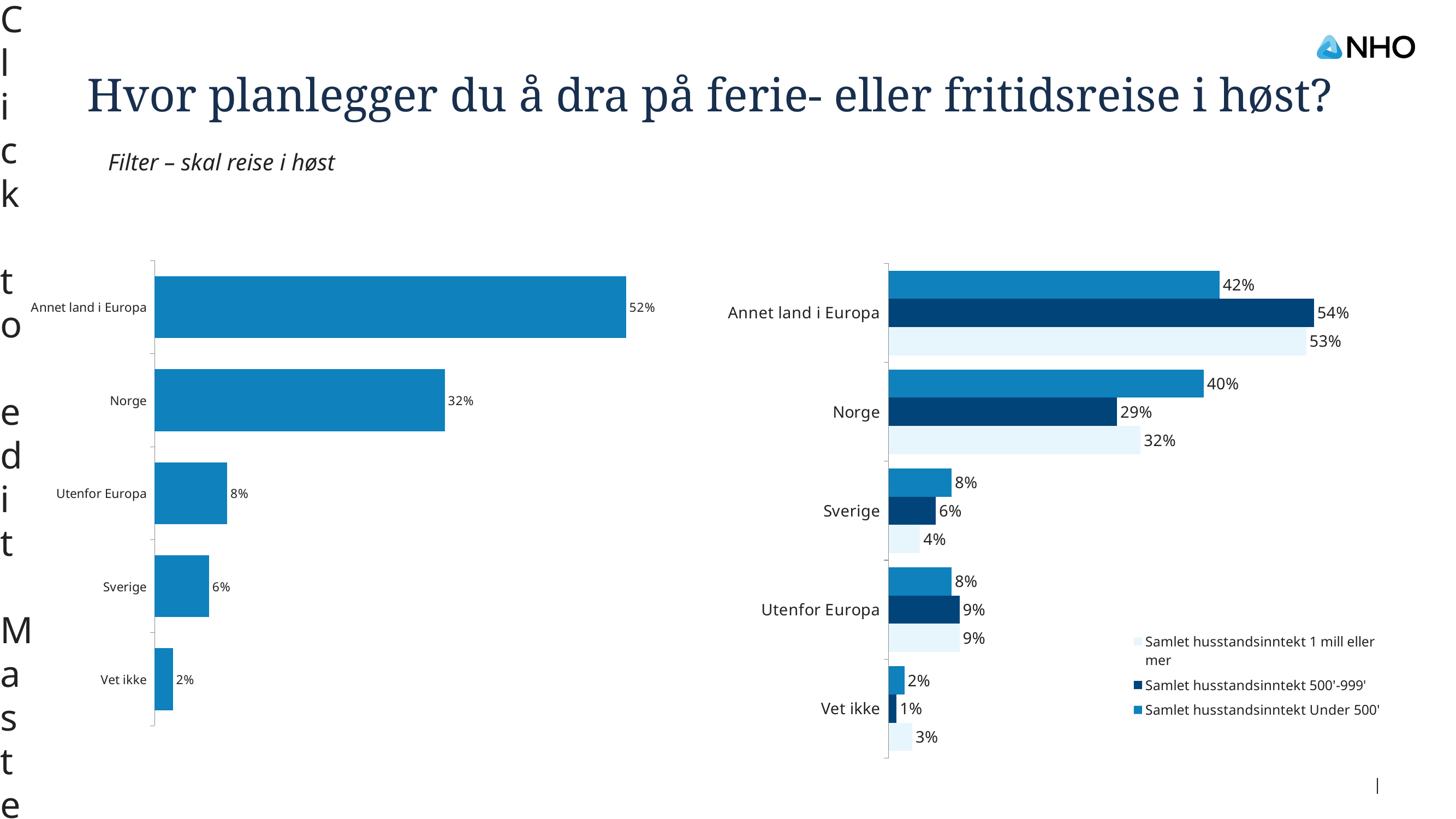
What kind of chart is the left chart? Bar chart In the right chart, what is the difference between Samlet husstandsinntekt Under 500' and Samlet husstandsinntekt 1 mill eller mer for Annet land i Europa? 11 percentage points In the right chart, what is the value for Annet land i Europa for Samlet husstandsinntekt 500'-999'? 54% In the right chart, for Norge, which is larger: Samlet husstandsinntekt Under 500' or Samlet husstandsinntekt 500'-999'? Samlet husstandsinntekt Under 500' In the right chart, what is the value for Sverige for Samlet husstandsinntekt 1 mill eller mer? 4% In the right chart, how many series does the legend list? 3 In the left chart, which category has the lowest value? Vet ikke In the left chart, how many categories are shown? 5 In the left chart, what is the difference between Annet land i Europa and Norge? 20 percentage points In the left chart, what is the value for Norge? 32% In the right chart, what is the value for Norge for Samlet husstandsinntekt Under 500'? 40% In the left chart, which category has the highest value? Annet land i Europa